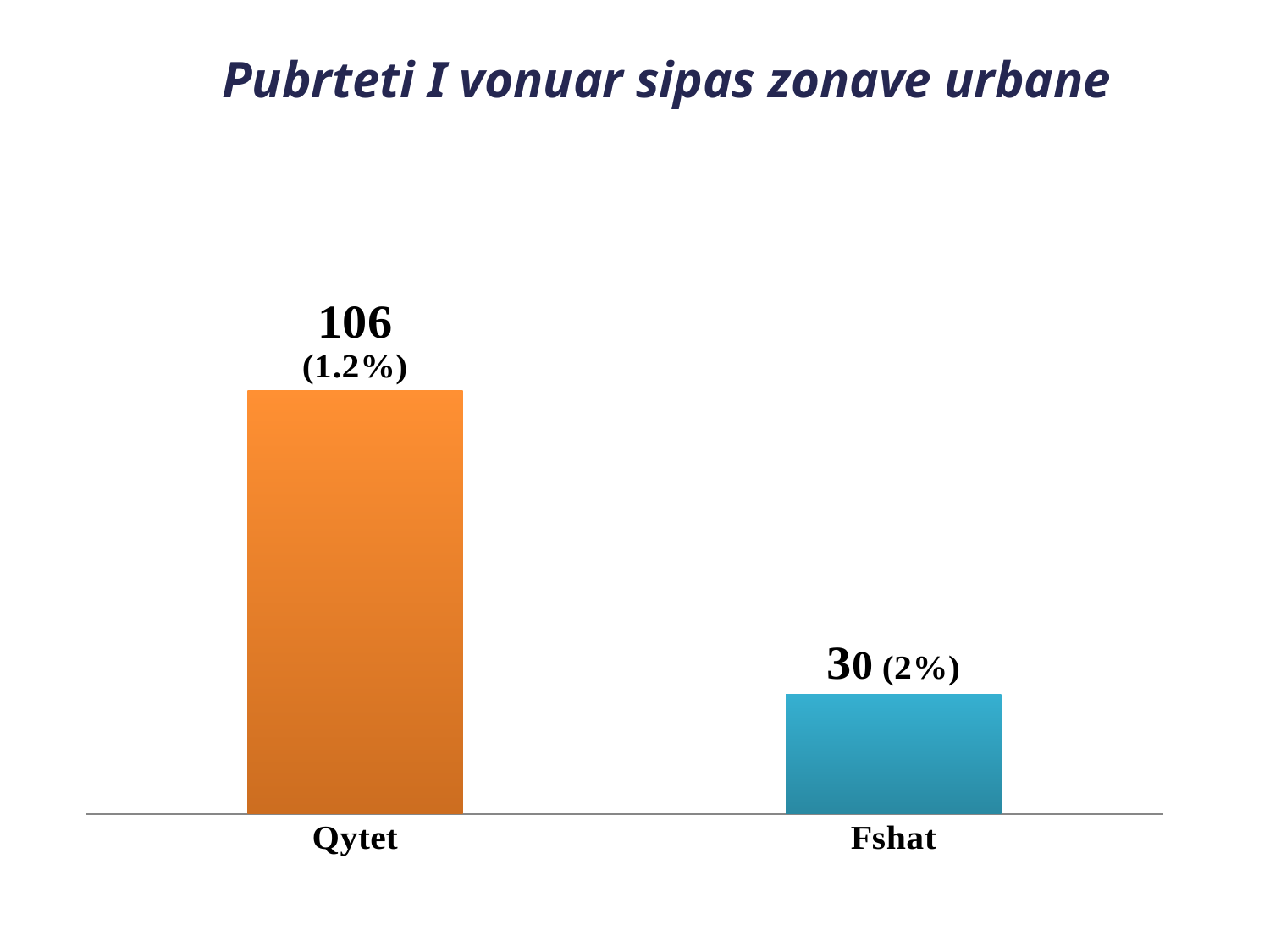
What percentage is shown in parentheses for Qytet? 1.2% What is the value for Qytet? 106 Which category has the highest value? Qytet What is the value for Fshat? 30 Which is larger, the value for Qytet or the value for Fshat? Qytet What is the difference between the values for Qytet and Fshat? 76 What colour is the bar for Fshat? Blue Which category has the lowest value? Fshat What percentage is shown in parentheses for Fshat? 2% How many categories are shown on the chart? 2 What is the title of the chart? Pubrteti I vonuar sipas zonave urbane What kind of chart is shown on the slide? Bar chart